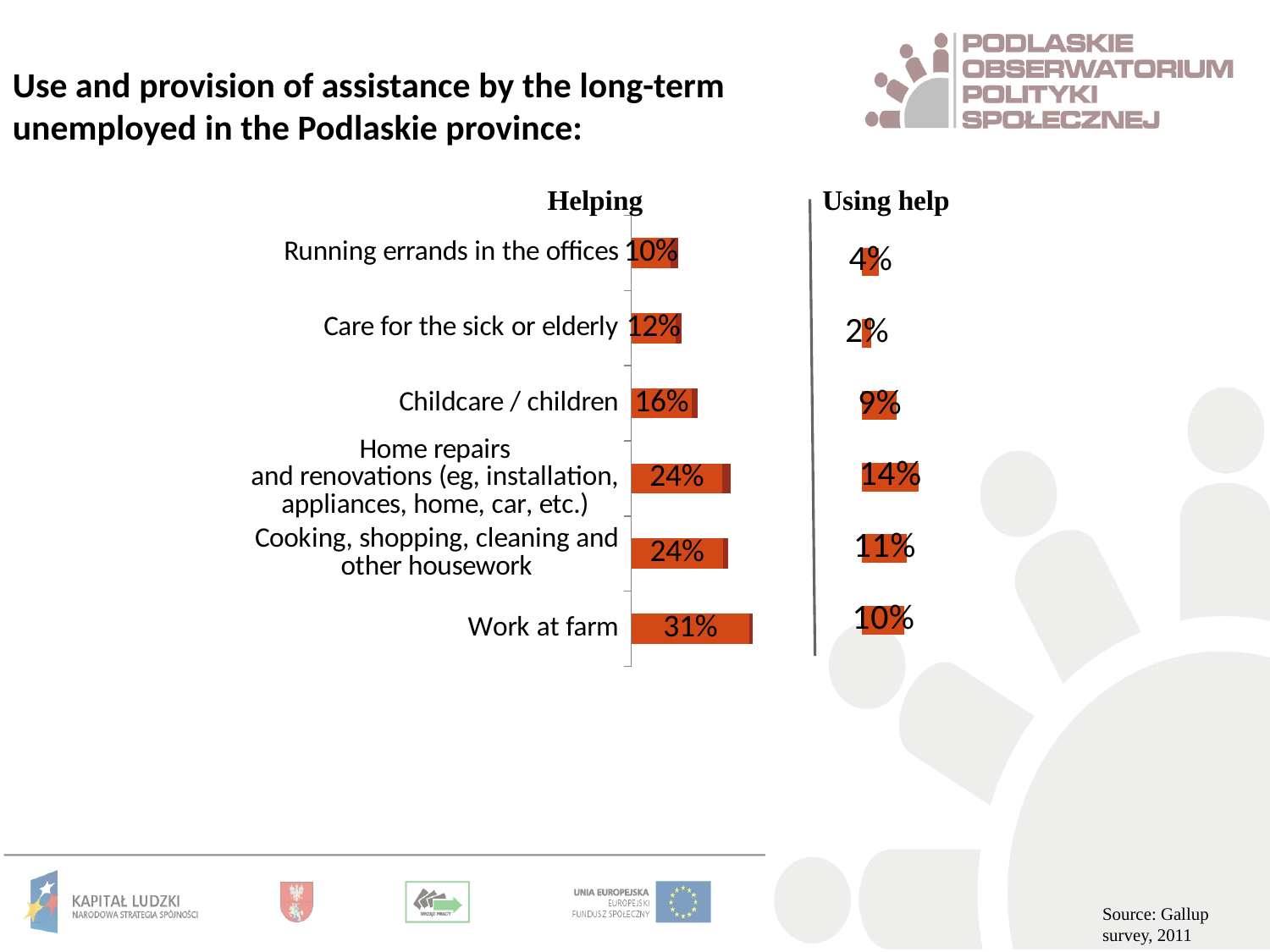
In the "Helping" chart, which category has the highest value? Work at farm In the "Helping" chart, what is the value for Childcare / children? 16% In the "Helping" chart, what is the difference between Work at farm and Running errands in the offices? 21% What type of chart is the "Helping" chart? Bar chart In the "Using help" chart, which category has the highest value? Home repairs and renovations In the "Using help" chart, which category has the lowest value? Care for the sick or elderly In the "Helping" chart, what is the difference between Cooking, shopping, cleaning and other housework and Care for the sick or elderly? 12% How many categories are shown in the "Helping" chart? 6 In the "Using help" chart, which is larger: Childcare / children or Running errands in the offices? Childcare / children In the "Using help" chart, what is the value for Care for the sick or elderly? 2% In the "Helping" chart, what is the value for Work at farm? 31% In the "Using help" chart, what is the value for Home repairs and renovations? 14%